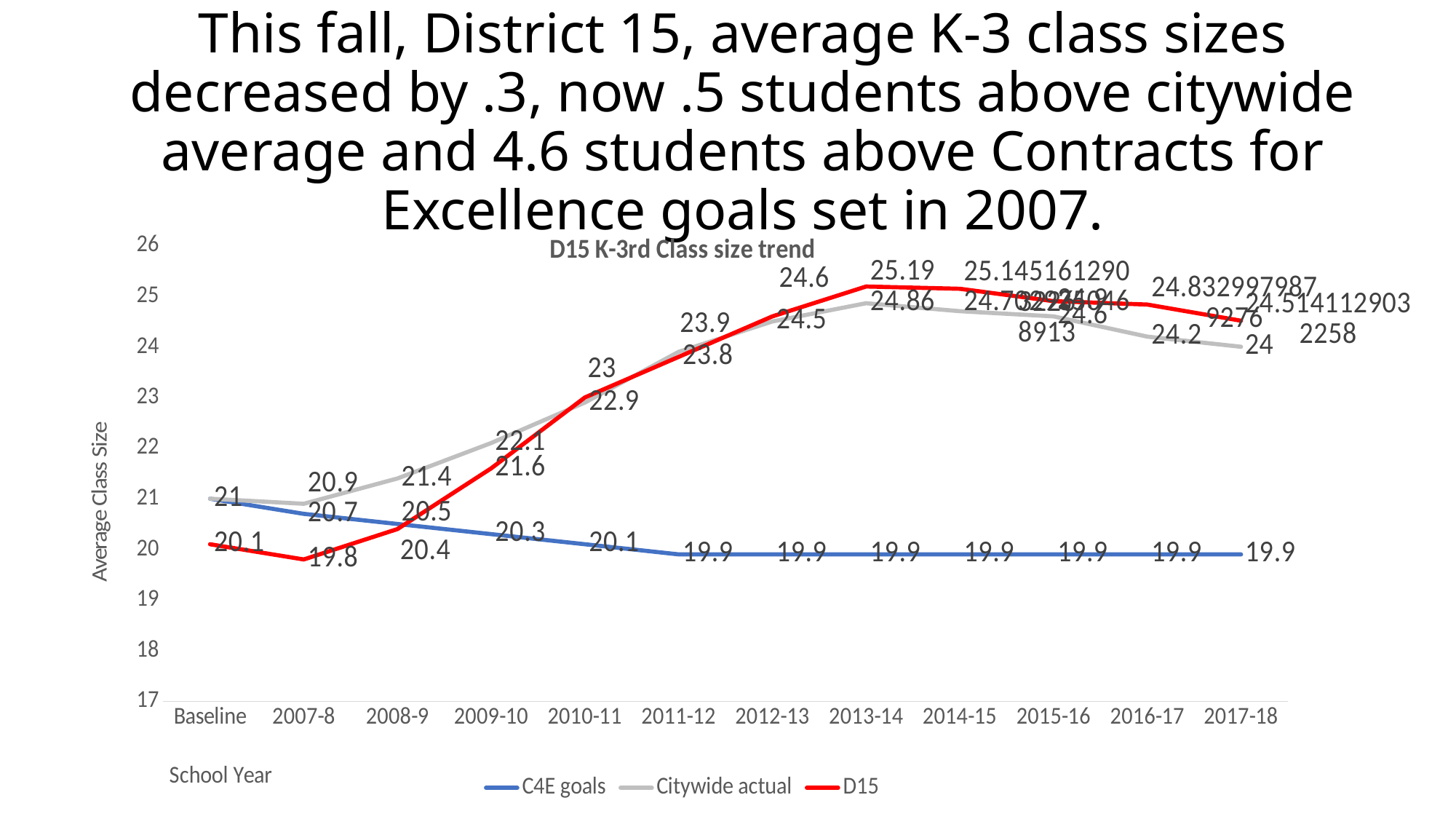
What is the C4E goals value for 2017-18? 19.9 In which school year is the D15 value lowest? 2007-8 Which is larger in 2009-10, the Citywide actual value or the D15 value? Citywide actual What is the D15 value for 2013-14? 25.19 What is the title of the chart? D15 K-3rd Class size trend How many series does the chart legend list? 3 What is the D15 value for 2007-8? 19.8 Is the D15 value for 2017-18 greater or less than 24? greater How many school-year categories are shown on the x axis? 12 What kind of chart is shown on the slide? line chart What is the difference between the Citywide actual value and the C4E goals value in 2017-18? 4.1 What is the Citywide actual value for 2017-18? 24